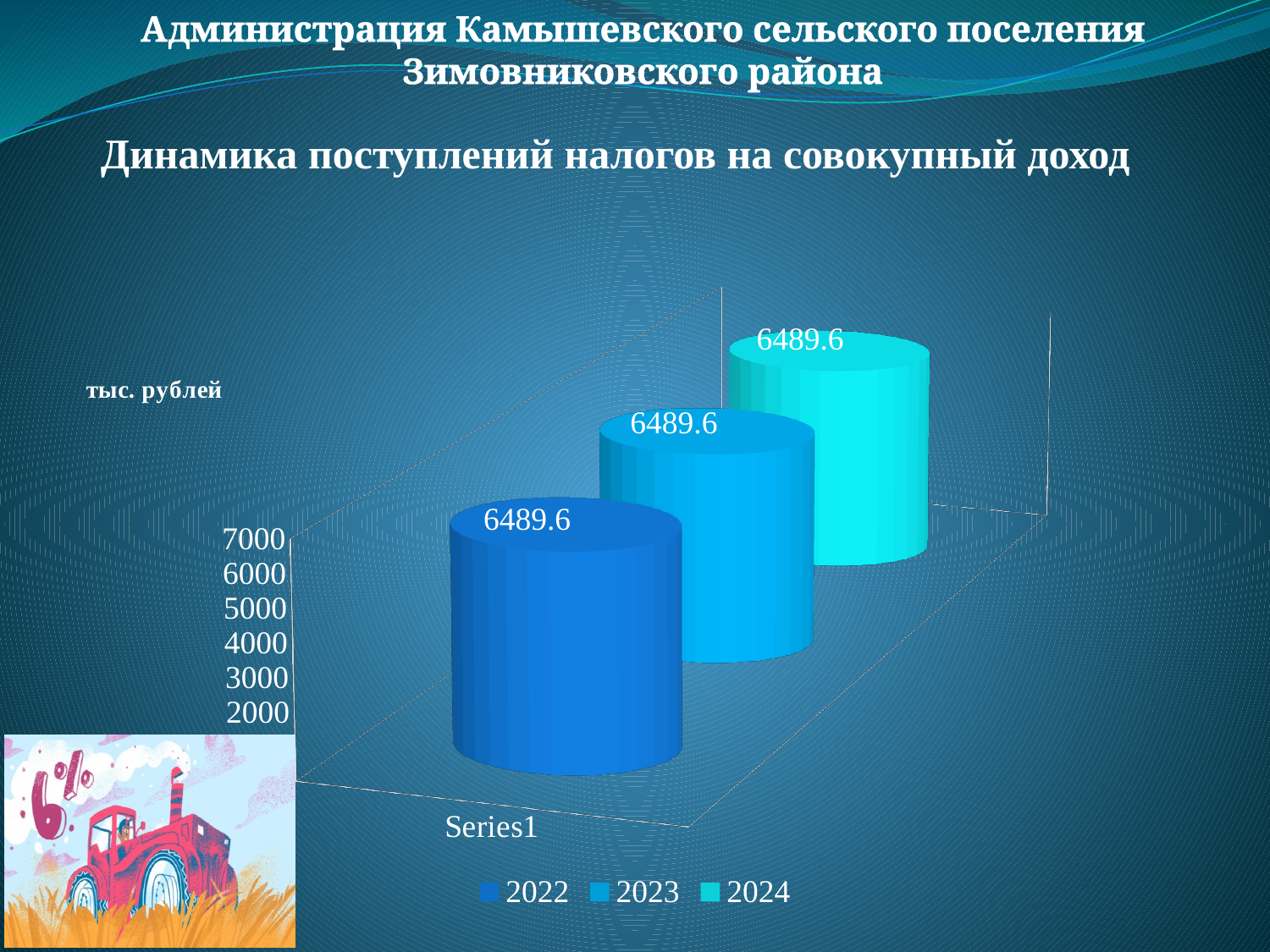
What is the title of the chart? Динамика поступлений налогов на совокупный доход What unit is indicated for the values on the chart? тыс. рублей What is the value for 2023 on the chart? 6489.6 What kind of chart is shown on the slide? bar chart Is the value for 2023 greater or less than 6000? greater Do the values rise, fall or stay the same from 2022 to 2024? stay the same How many series does the legend list? 3 What is the value for 2024 on the chart? 6489.6 Is the value for 2024 greater or less than 7000? less What is the difference between the values for 2024 and 2022? 0 What is the value for 2022 on the chart? 6489.6 What is the highest tick value shown on the vertical axis? 7000